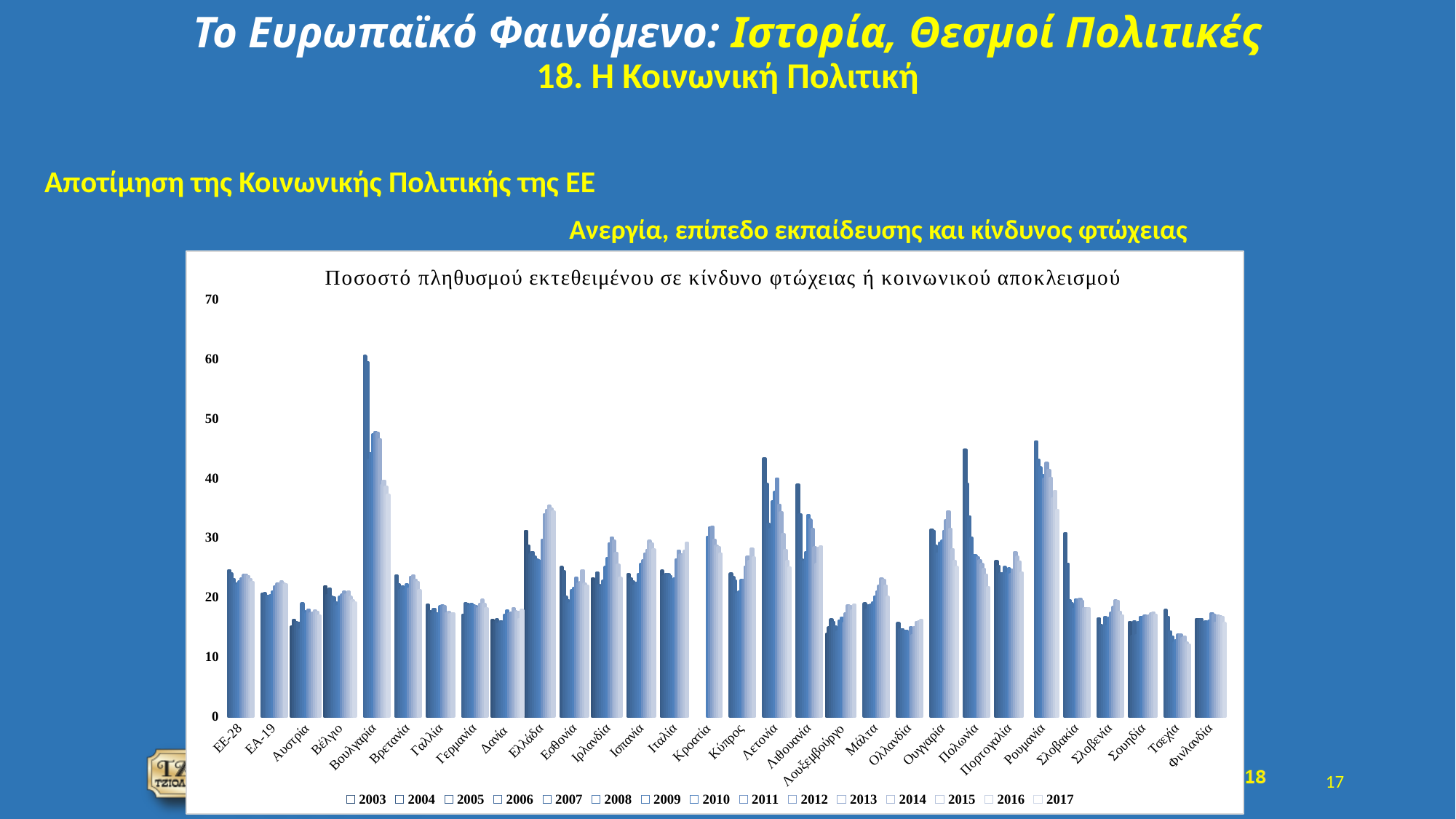
How many series does the legend list? 15 What is the first year listed in the legend? 2003 What kind of chart is shown on the slide? bar chart Is the highest value for Ρουμανία greater or less than 40? greater Are the values for Τσεχία greater or less than 20? less What is the last year listed in the legend? 2017 Is the highest value for Βουλγαρία greater or less than 50? greater Which country has the tallest bar in the chart? Βουλγαρία How many countries or groups are shown along the x axis? 30 Do the values for Ελλάδα rise or fall from 2003 to 2017? rise Do the values for Βουλγαρία rise or fall from 2003 to 2017? fall